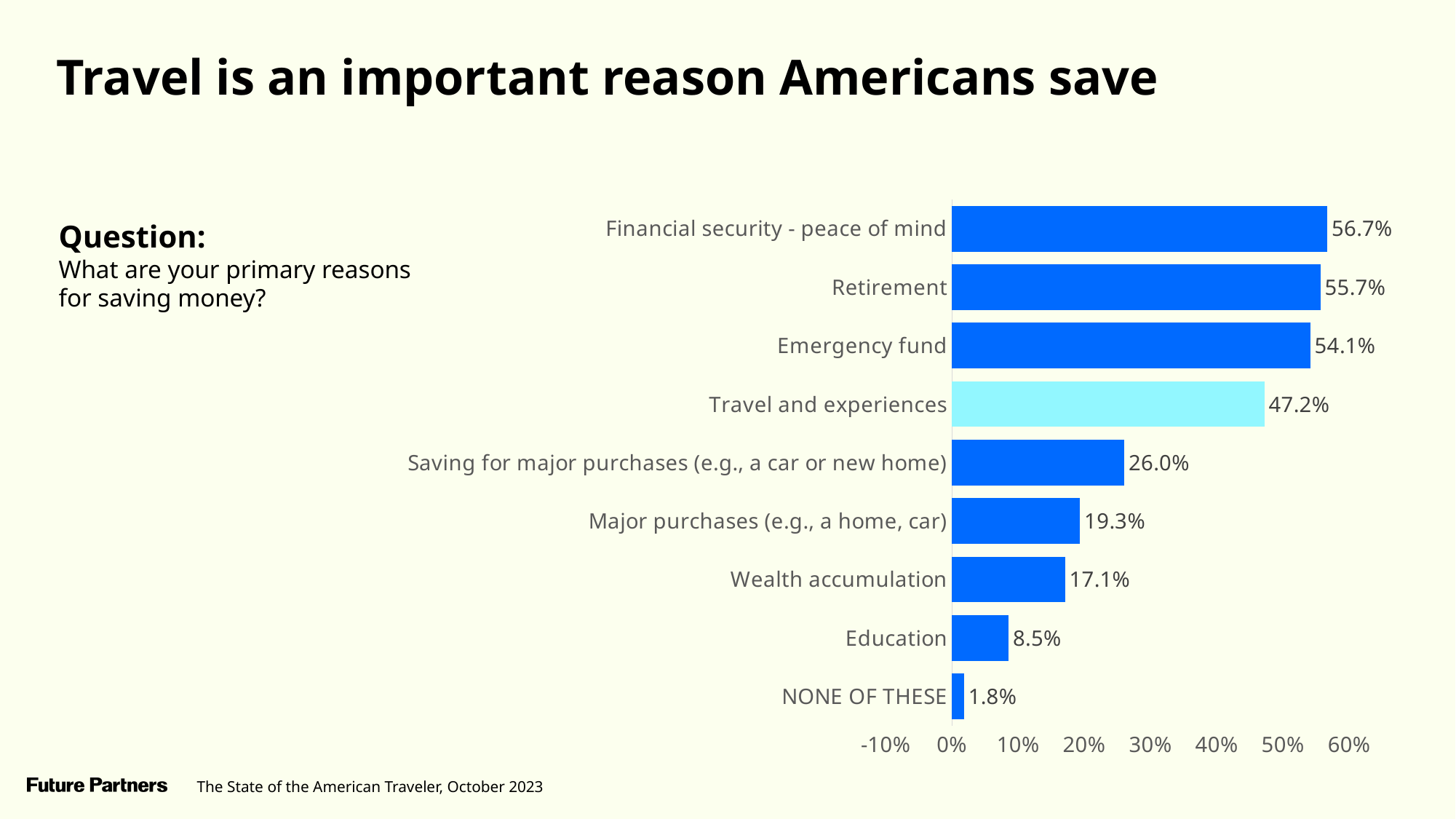
How many categories are shown in the chart? 9 Which bar is highlighted in a lighter colour than the others? Travel and experiences What is the difference between Financial security - peace of mind and Retirement? 1.0% What kind of chart is shown on the slide? Bar chart Which is larger: Wealth accumulation or Major purchases (e.g., a home, car)? Major purchases (e.g., a home, car) What is the value shown for Retirement? 55.7% What is the value shown for Education? 8.5% What percentage of respondents cited Travel and experiences as a primary reason for saving money? 47.2% What is the difference between Emergency fund and Travel and experiences? 6.9% Which reason for saving has the highest percentage? Financial security - peace of mind Is the value for Saving for major purchases (e.g., a car or new home) greater or less than 30%? less Which category has the lowest percentage? NONE OF THESE